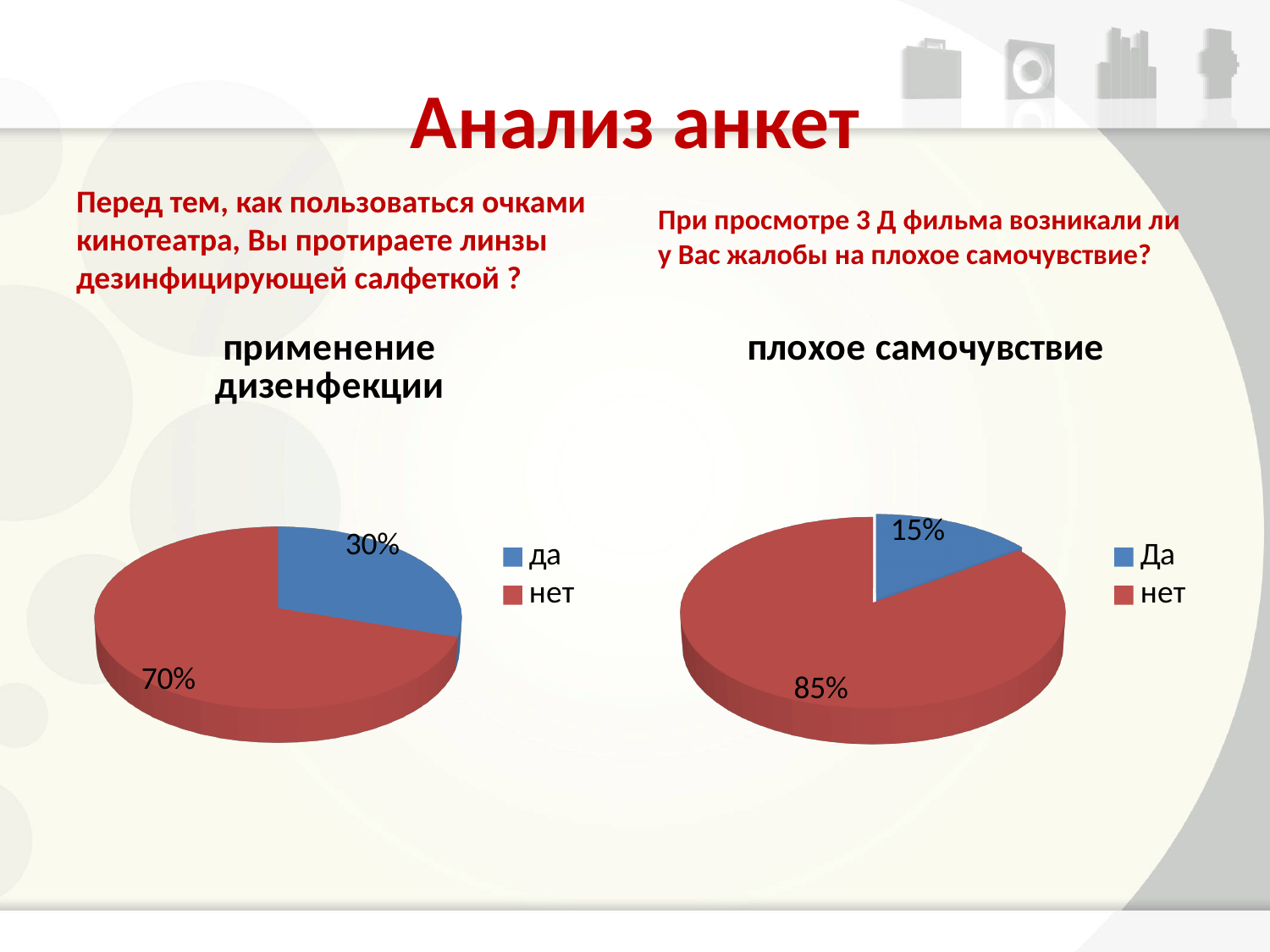
In the chart titled "применение дизенфекции", what share of the pie is "да"? 30% In the chart titled "применение дизенфекции", which category has the largest slice? нет In the chart titled "плохое самочувствие", what colour is the "нет" slice? red In the chart titled "плохое самочувствие", what share of the pie is "нет"? 85% In the chart titled "применение дизенфекции", what share of the pie is "нет"? 70% In the chart titled "плохое самочувствие", what is the difference between the "нет" and "Да" shares? 70% In the chart titled "плохое самочувствие", which category has the smallest slice? Да How many categories does the chart titled "применение дизенфекции" show? 2 Which is larger: the "да" share in the chart titled "применение дизенфекции" or the "Да" share in the chart titled "плохое самочувствие"? применение дизенфекции In the chart titled "применение дизенфекции", what is the difference between the "нет" and "да" shares? 40% What kind of chart is the chart titled "плохое самочувствие"? pie chart